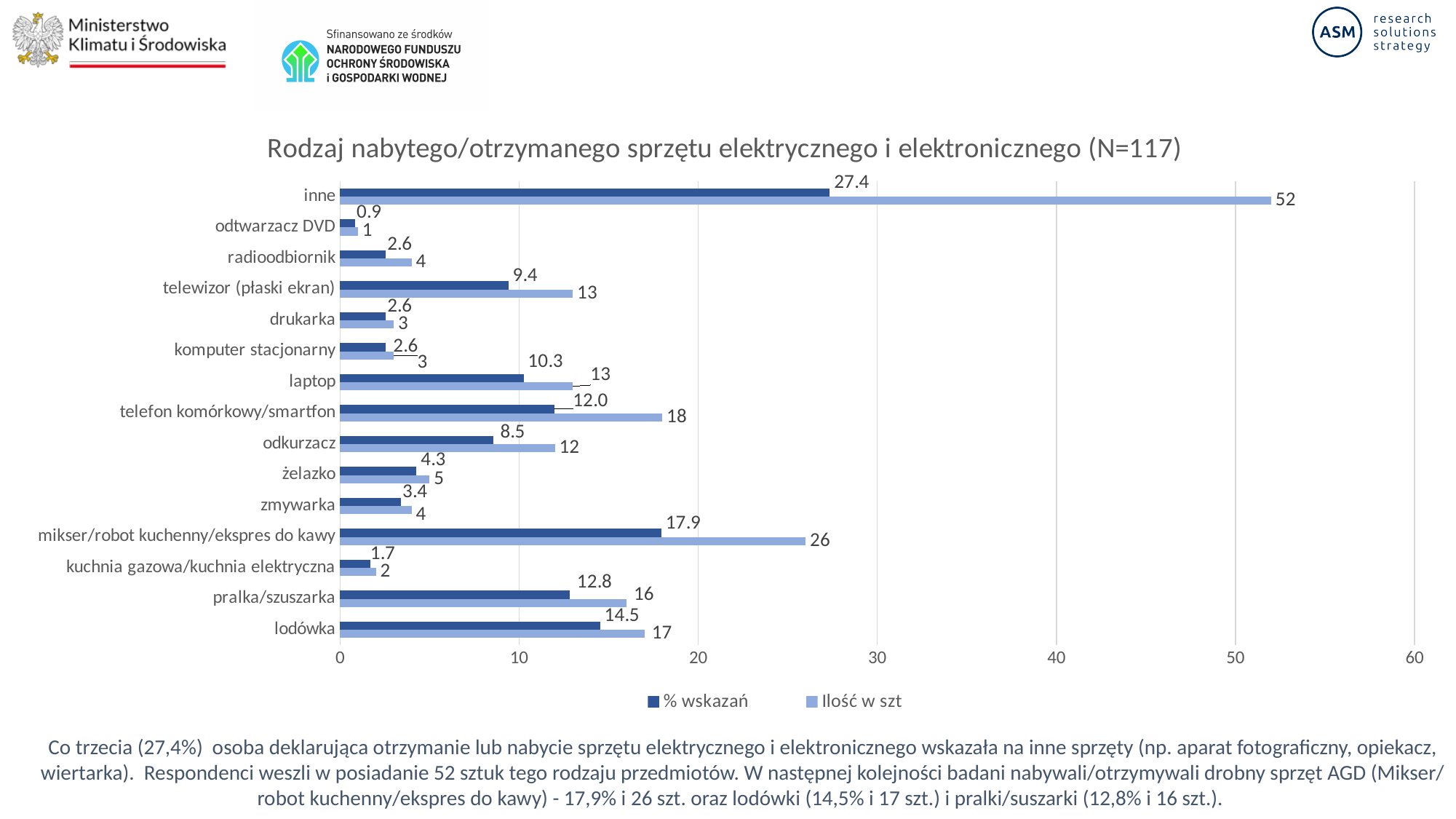
What is the "% wskazań" value for "mikser/robot kuchenny/ekspres do kawy"? 17.9 Which has a larger "% wskazań" value: "pralka/suszarka" or "laptop"? pralka/szuszarka What is the "% wskazań" value for "lodówka"? 14.5 Which category has the highest "Ilość w szt" value? inne Which category has the lowest "% wskazań" value? odtwarzacz DVD What is the difference between the "Ilość w szt" values for "inne" and "mikser/robot kuchenny/ekspres do kawy"? 26 What is the title of the chart? Rodzaj nabytego/otrzymanego sprzętu elektrycznego i elektronicznego (N=117) What type of chart is shown on the slide? bar chart How many series does the legend list? 2 What is the "Ilość w szt" value for "telefon komórkowy/smartfon"? 18 What is the "Ilość w szt" value for "inne"? 52 How many categories are plotted on the chart? 15